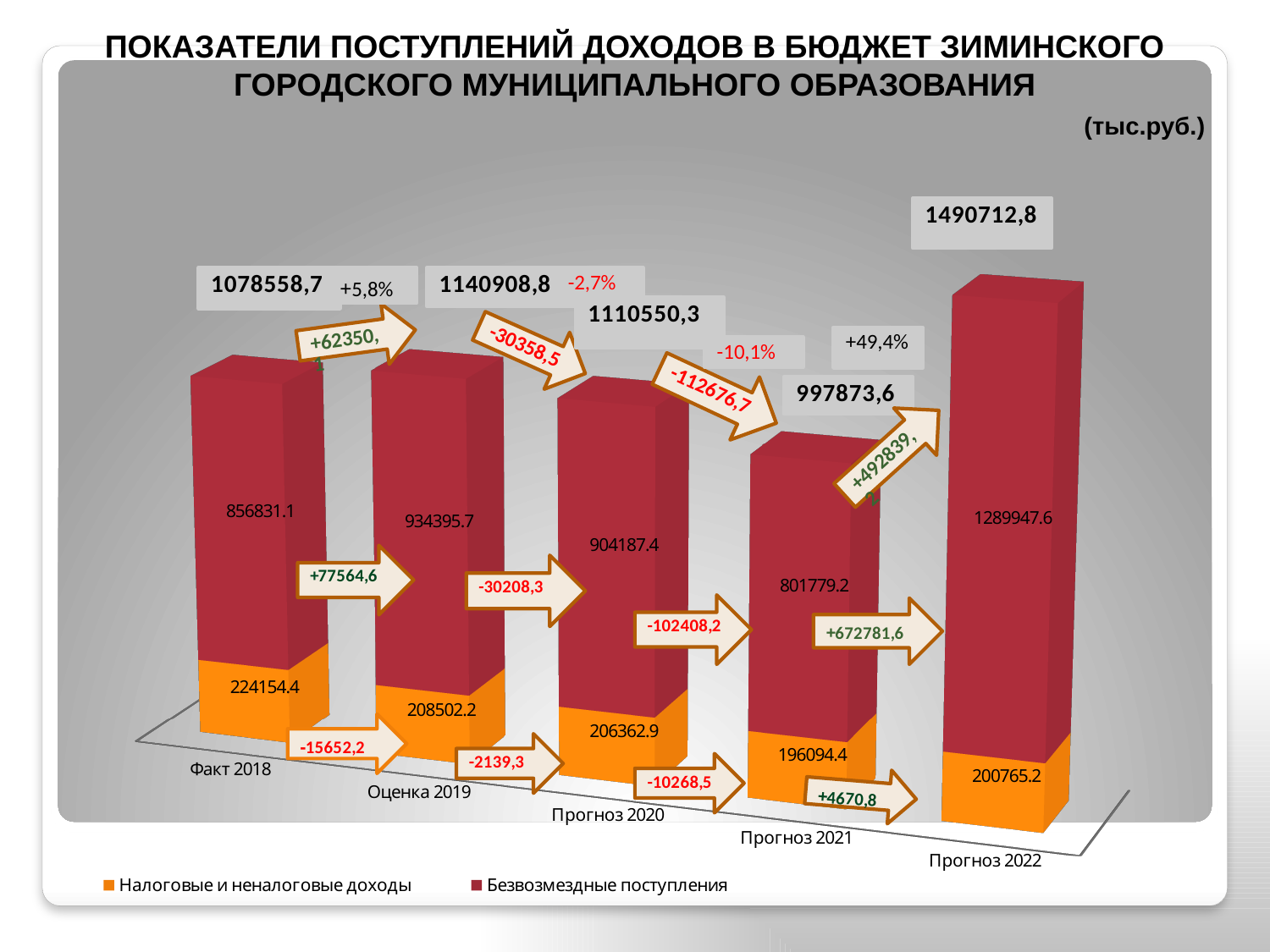
What is the value of Безвозмездные поступления for Факт 2018? 856831.1 Which is larger: Налоговые и неналоговые доходы for Факт 2018 or for Прогноз 2020? Факт 2018 Which category has the highest value of Безвозмездные поступления? Прогноз 2022 How many series does the legend list? 2 What is the value of Налоговые и неналоговые доходы for Прогноз 2021? 196094.4 What is the difference between Безвозмездные поступления for Оценка 2019 and for Прогноз 2020? 30208.3 How many categories are shown along the x axis? 5 Which series is shown in orange in the legend? Налоговые и неналоговые доходы Which category has the lowest value of Налоговые и неналоговые доходы? Прогноз 2021 What kind of chart is shown on the slide? Stacked bar chart What is the value of Безвозмездные поступления for Прогноз 2022? 1289947.6